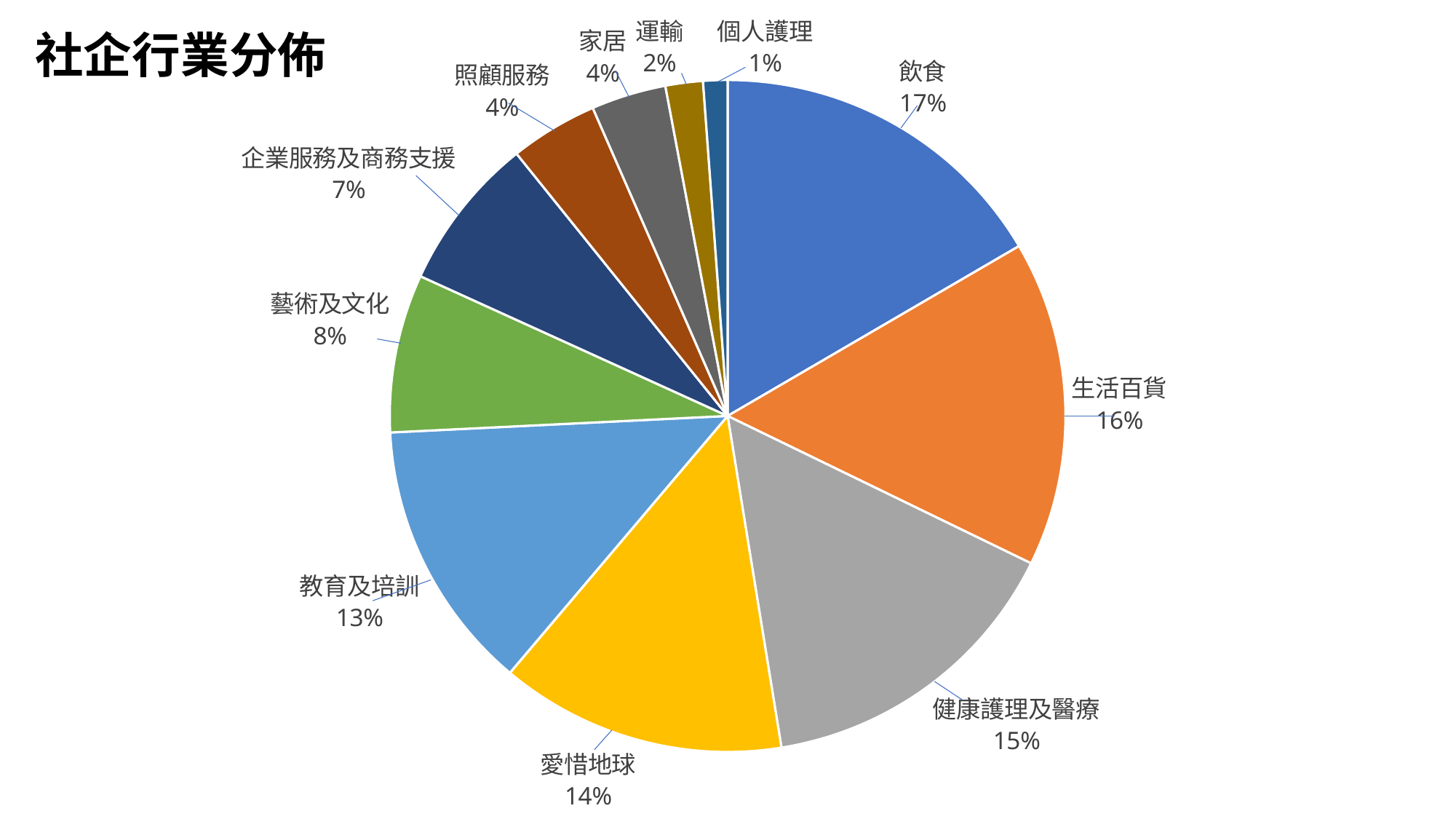
Which category has the smallest share of the pie? 個人護理 What is the difference between the shares of 照顧服務 and 個人護理? 3% Which category has the largest share of the pie? 飲食 Which is larger, the share for 愛惜地球 or the share for 企業服務及商務支援? 愛惜地球 What is the title of the chart? 社企行業分佈 What type of chart is shown on the slide? pie chart What is the value shown for 教育及培訓? 13% How many slices does the pie chart have? 11 What is the value shown for 運輸? 2% What is the difference between the shares of 生活百貨 and 藝術及文化? 8% What share of the pie does 飲食 represent? 17% What is the value shown for 健康護理及醫療? 15%